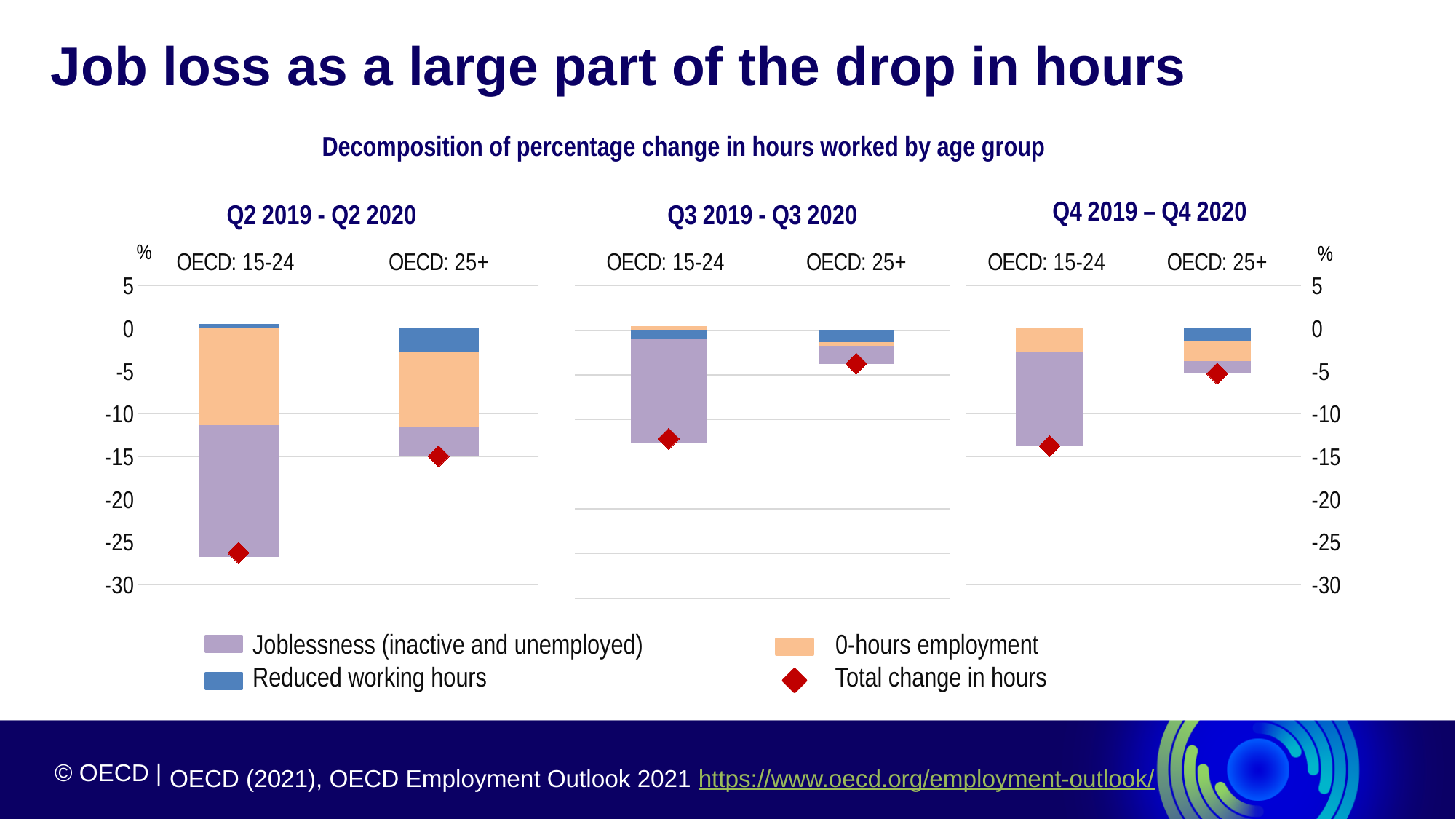
What is the subtitle describing what the charts show? Decomposition of percentage change in hours worked by age group What kind of chart is used in each of the three panels on the slide? Stacked bar chart In the Q4 2019 – Q4 2020 chart, which age group shows the larger total drop in hours, OECD: 15-24 or OECD: 25+? OECD: 15-24 In the Q2 2019 - Q2 2020 chart, how many age-group categories are plotted? 2 In the Q2 2019 - Q2 2020 chart, is the total change in hours for OECD: 15-24 greater or less than -20? less In the Q2 2019 - Q2 2020 chart, which age group shows the larger total drop in hours, OECD: 15-24 or OECD: 25+? OECD: 15-24 In the Q4 2019 – Q4 2020 chart, is the total change in hours for OECD: 15-24 greater or less than -10? less Which legend entry is represented by a red diamond marker? Total change in hours In the Q3 2019 - Q3 2020 chart, which age group shows the larger total drop in hours, OECD: 15-24 or OECD: 25+? OECD: 15-24 In the Q2 2019 - Q2 2020 chart, is the total change in hours for OECD: 25+ greater or less than -10? less How many entries does the legend list? 4